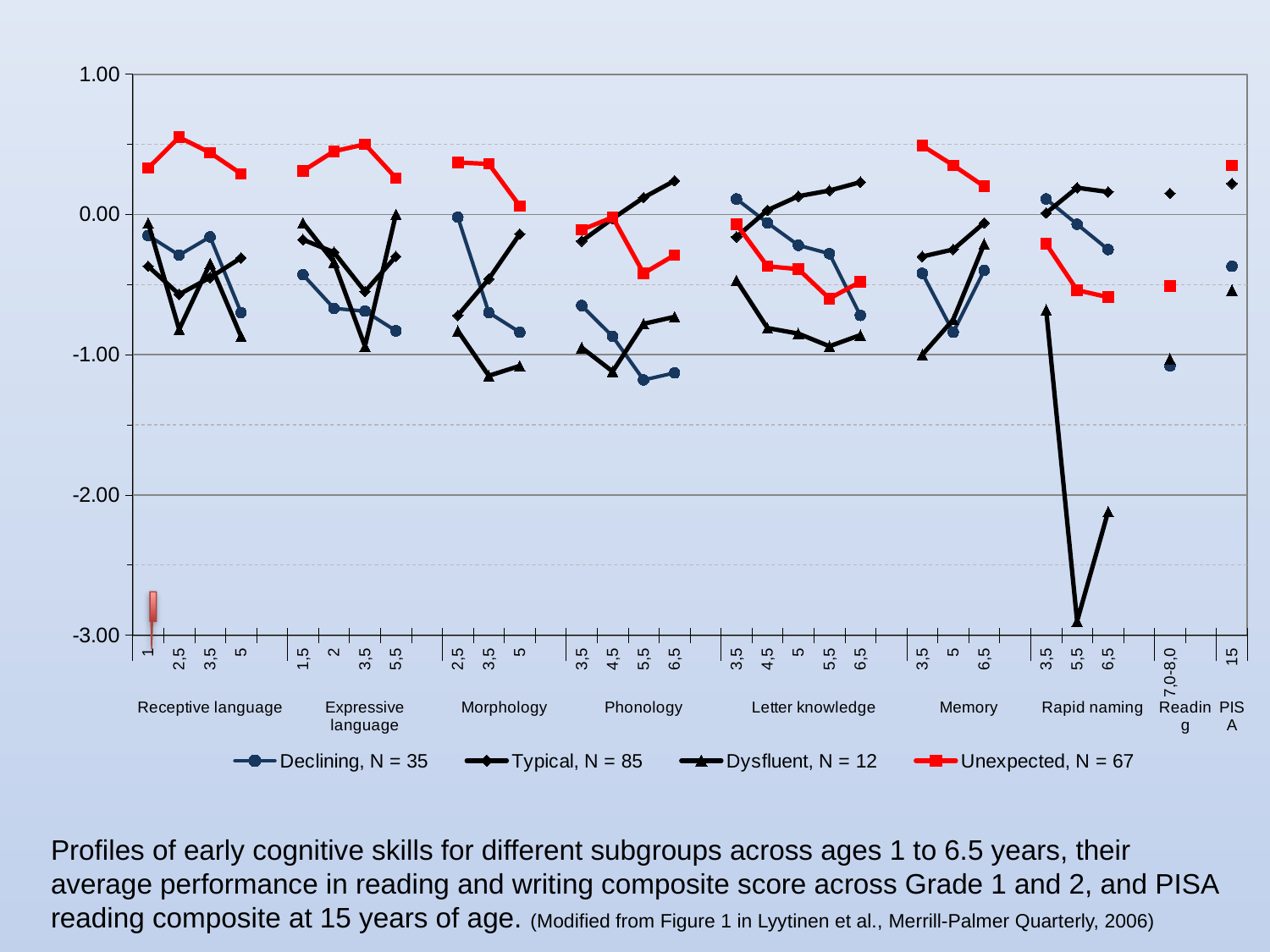
How many skill domains are labelled along the x axis (from Receptive language to PISA)? 9 Do the values for the Unexpected group rise or fall across ages 2,5 to 5 in the Morphology domain? fall Which series has the lowest value at age 5,5 in the Rapid naming domain? Dysfluent, N = 12 At PISA (age 15), which is larger: the value for the Typical group or the Dysfluent group? Typical group Which series has the highest value at age 2,5 in the Receptive language domain? Unexpected, N = 67 What sample size (N) does the legend give for the Typical group? 85 How many series does the legend list? 4 Is the value for the Unexpected group at age 3,5 in Memory greater or less than 0.00? greater Is the value for the Declining group at age 5,5 in Phonology greater or less than -1.00? less At age 6,5 in Phonology, which is larger: the value for the Unexpected group or the Declining group? Unexpected group Is the value for the Dysfluent group at age 5,5 in Rapid naming greater or less than -2.00? less What kind of chart is shown on the slide? Line chart